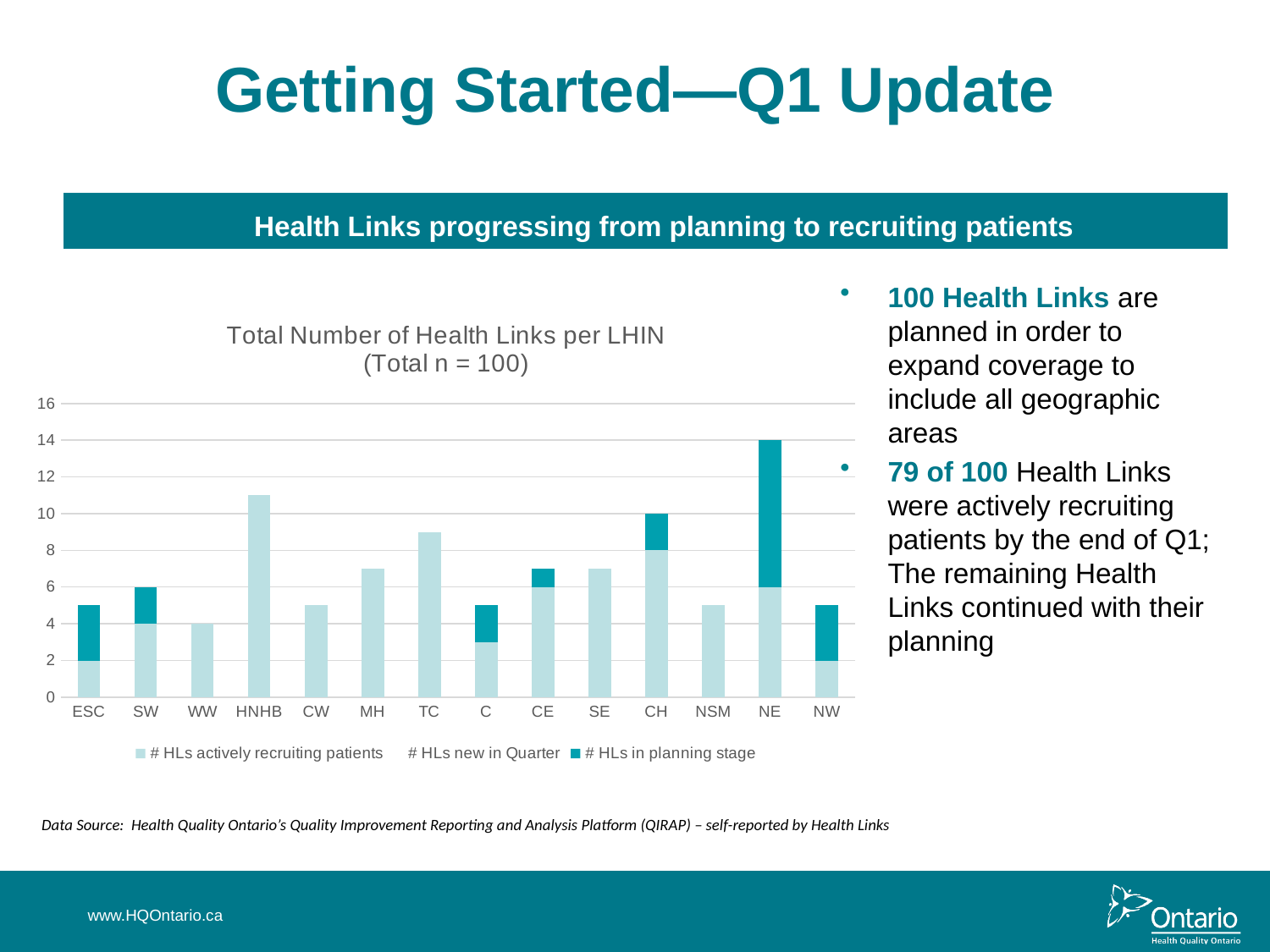
Is the total number of Health Links for HNHB greater or less than 10? greater What is the title of the chart? Total Number of Health Links per LHIN (Total n = 100) What is the number of HLs actively recruiting patients for SW? 4 How many series does the chart legend list? 3 What is the total number of Health Links for NE? 14 What kind of chart is shown on the slide? stacked bar chart Which LHIN has the highest total number of Health Links? NE What is the difference between the total Health Links for NE and CH? 4 How many LHIN categories are shown on the x axis of the chart? 14 What is the total number of Health Links for CH? 10 Which LHIN has the lowest total number of Health Links? WW What is the number of HLs actively recruiting patients for CH? 8